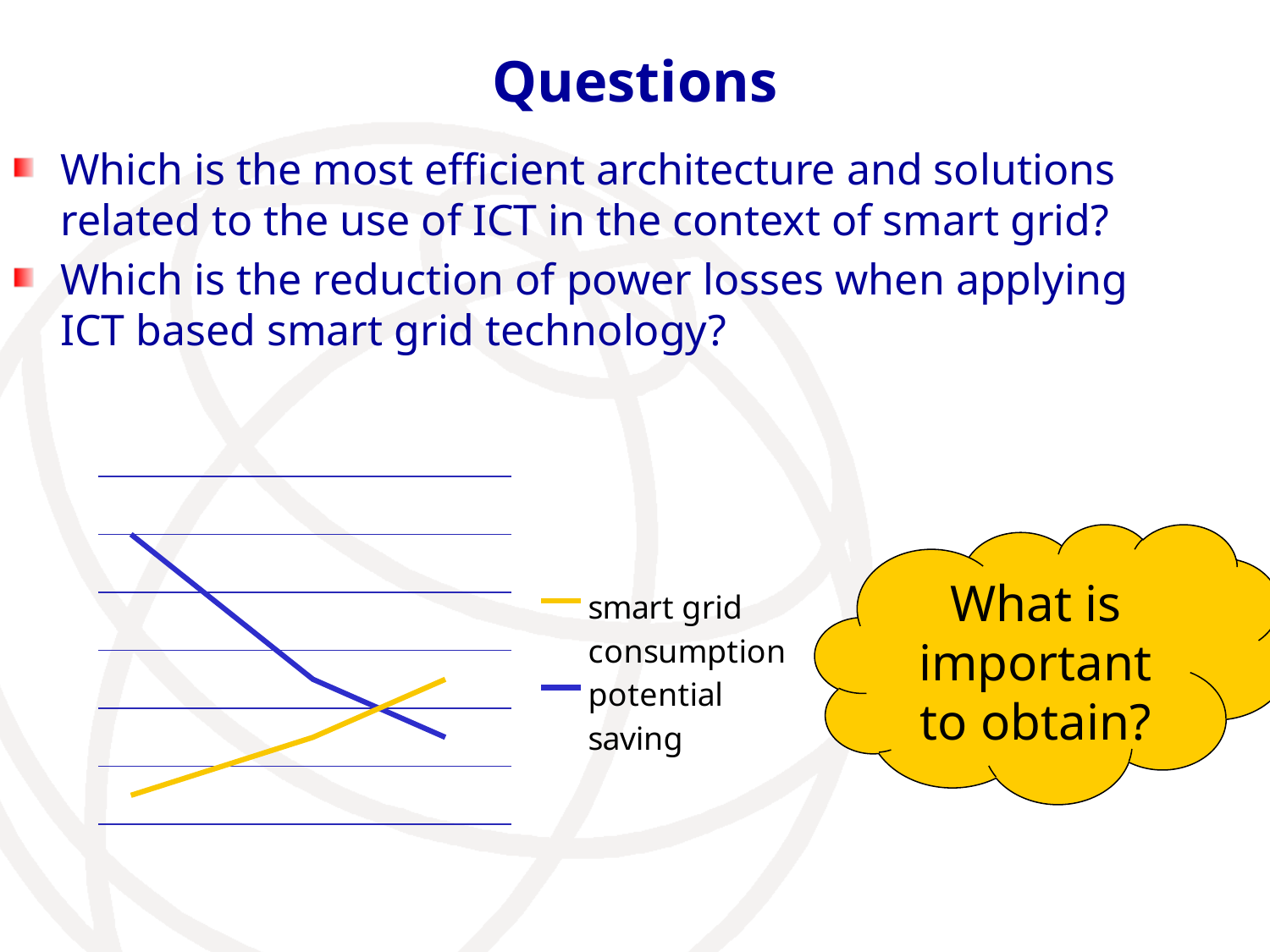
What kind of chart is shown on the slide? line chart Does the 'smart grid consumption' line rise or fall from left to right? rise How many series does the chart's legend list? 2 At the right end of the chart, which series has the higher value: 'smart grid consumption' or 'potential saving'? smart grid consumption Which series starts at the highest point on the chart? potential saving Which colour is used for the 'potential saving' series in the chart? blue Do the two lines in the chart cross each other? yes At the left end of the chart, which series has the higher value: 'smart grid consumption' or 'potential saving'? potential saving Does the 'potential saving' line rise or fall from left to right? fall What are the two series named in the chart's legend? smart grid consumption; potential saving Which series starts at the lowest point on the chart? smart grid consumption